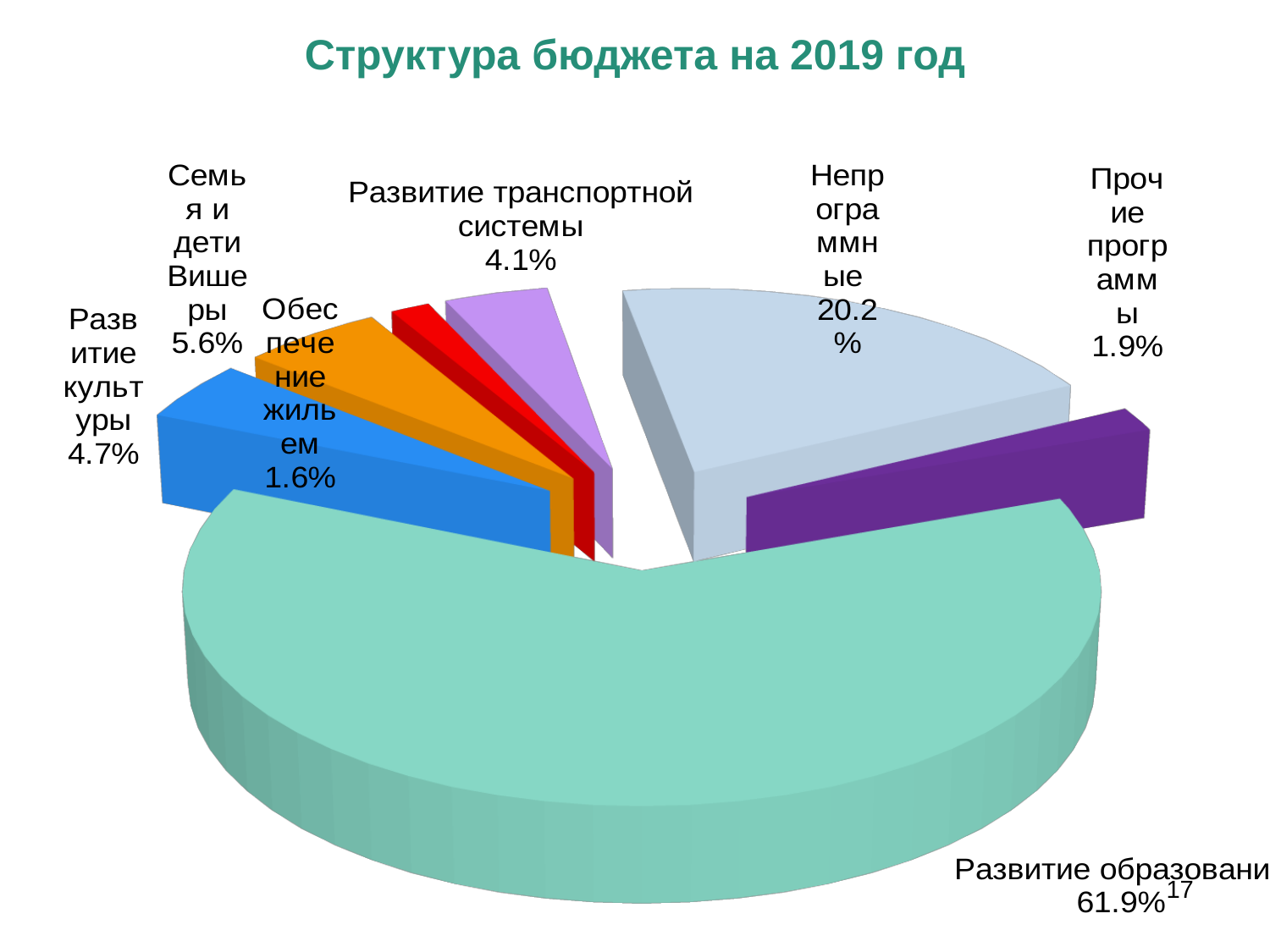
How many slices does the pie chart have? 7 What is the value for Непрограммные? 20.2% What share of the budget goes to Развитие образования? 61.9% What kind of chart is shown on the slide? Pie chart What is the value for Семья и дети Вишеры? 5.6% Which category has the smallest share of the budget? Обеспечение жильем What is the value for Развитие транспортной системы? 4.1% Which is larger: Развитие культуры or Прочие программы? Развитие культуры What is the difference between the shares of Развитие образования and Непрограммные? 41.7% What is the value for Обеспечение жильем? 1.6% What is the title of the chart? Структура бюджета на 2019 год Which category has the largest share of the budget? Развитие образования